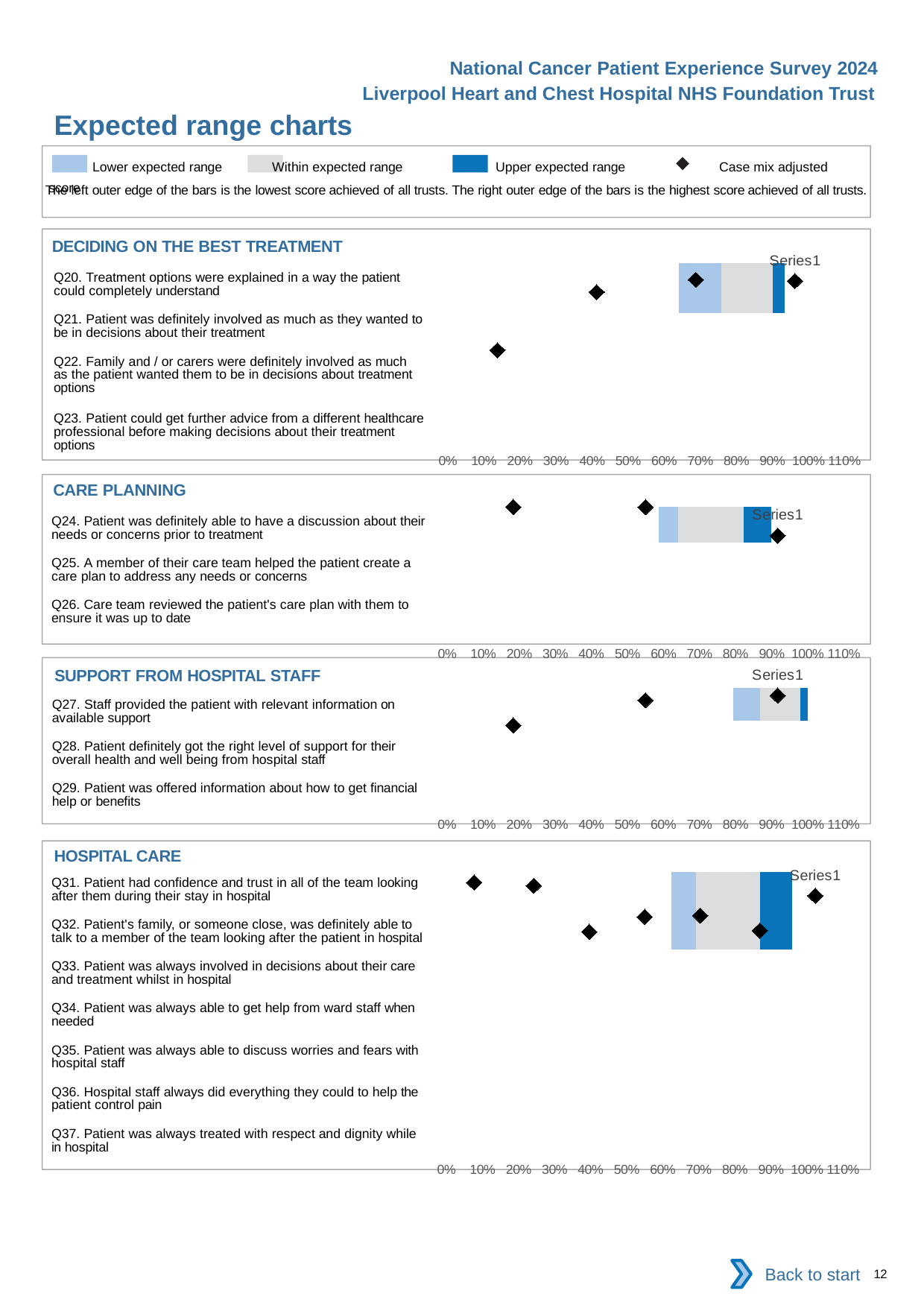
How many questions are listed in the CARE PLANNING chart? 3 What series name label appears on each of the charts? Series1 Which question is listed first in the CARE PLANNING chart? Q24. Patient was definitely able to have a discussion about their needs or concerns prior to treatment How many questions are listed in the HOSPITAL CARE chart? 7 Which legend entry is shown in dark blue? Upper expected range How many questions are listed in the DECIDING ON THE BEST TREATMENT chart? 4 Which question is listed last in the HOSPITAL CARE chart? Q37. Patient was always treated with respect and dignity while in hospital What kind of chart is used in the HOSPITAL CARE section? bar chart How many entries does the legend at the top of the slide list? 4